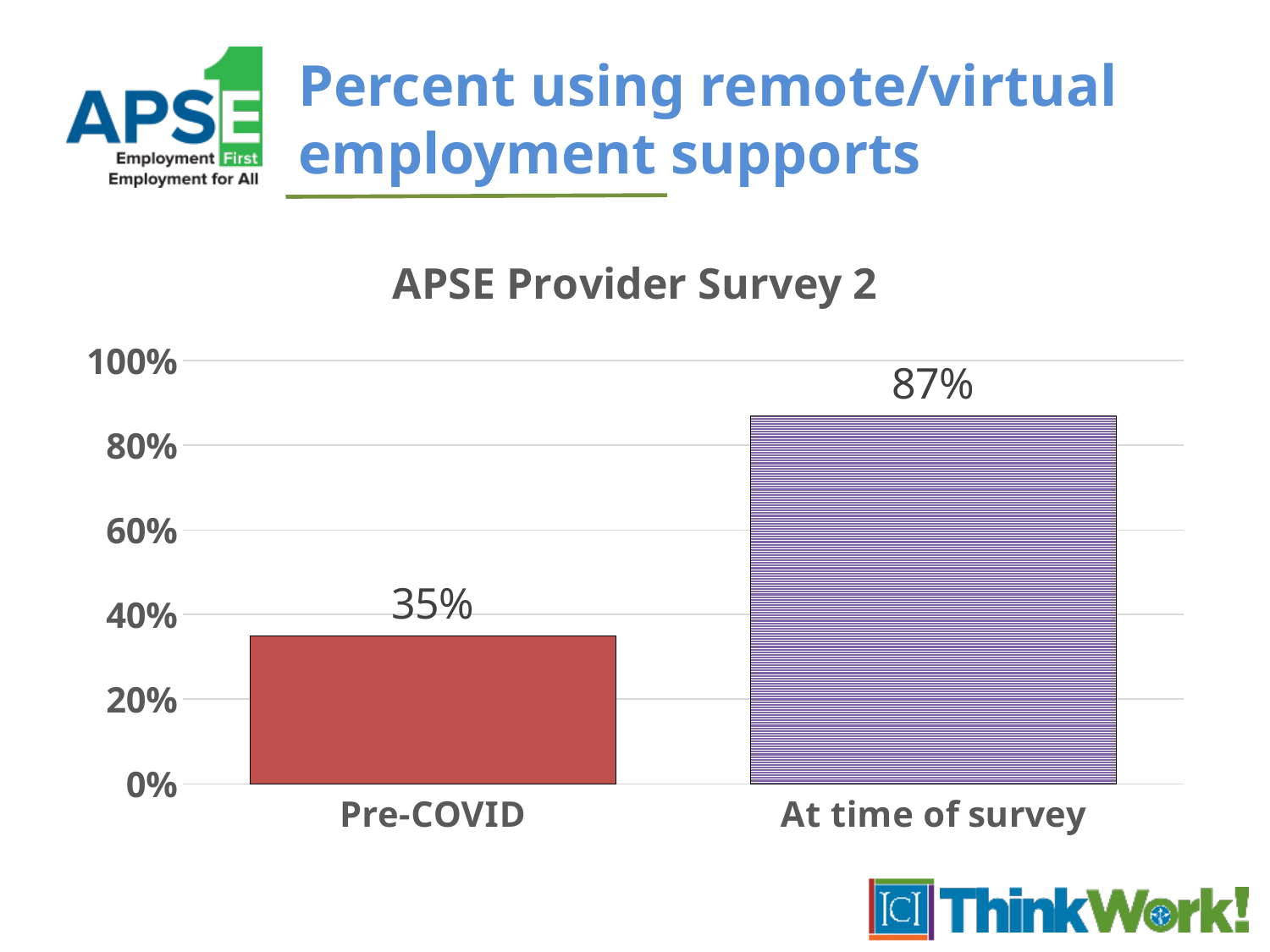
What is the difference between the At time of survey value and the Pre-COVID value? 52% Do the values rise or fall from Pre-COVID to At time of survey? rise Which category has the highest value? At time of survey Which category has the lowest value? Pre-COVID How many categories are shown on the x axis? 2 Which is larger, the value for Pre-COVID or the value for At time of survey? At time of survey What is the value for At time of survey? 87% Is the value for At time of survey greater or less than 80%? greater Is the value for Pre-COVID greater or less than 40%? less What kind of chart is shown on the slide? bar chart What is the value for Pre-COVID? 35% What is the title of the chart? APSE Provider Survey 2